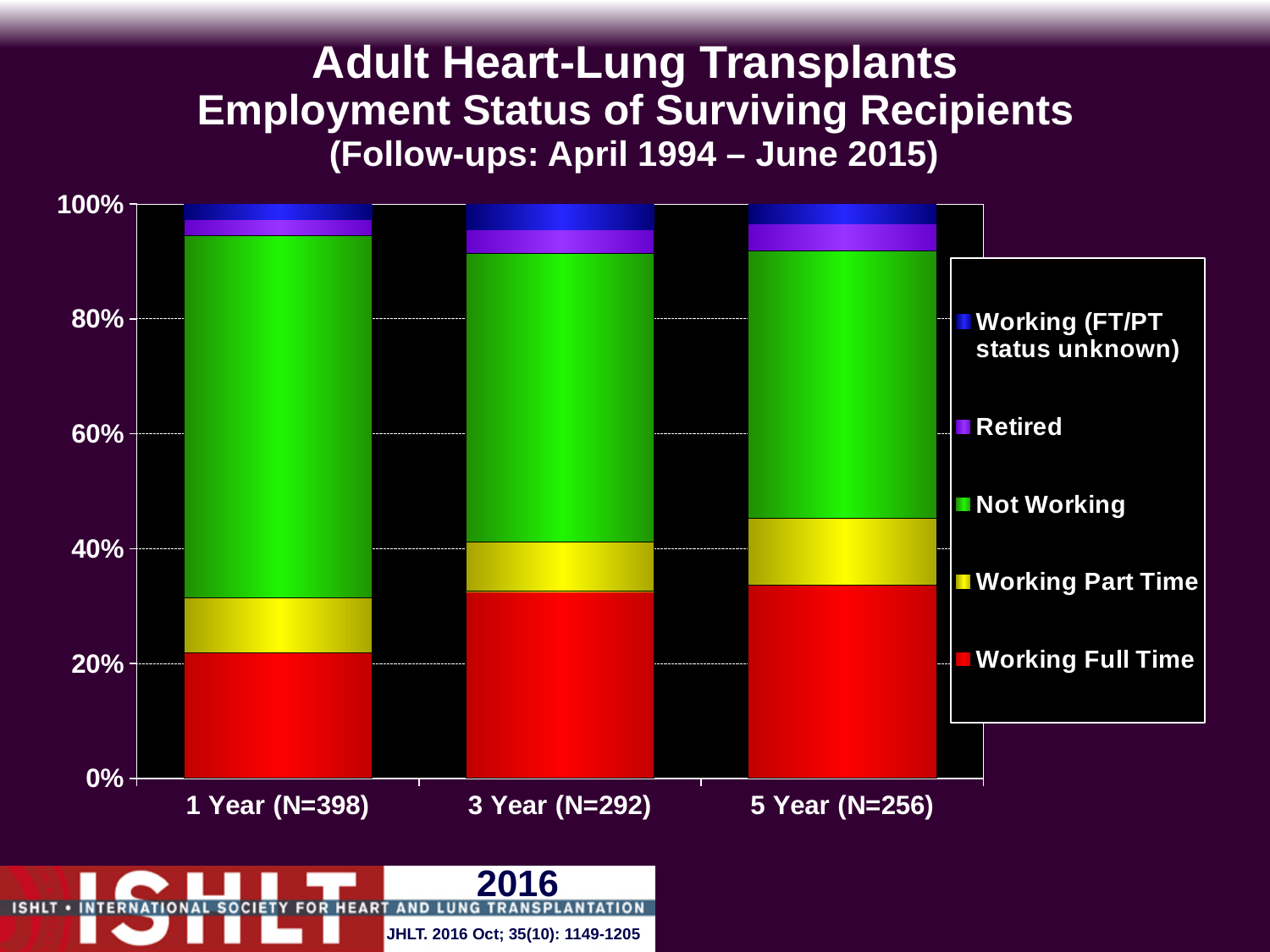
Is the Working Full Time share for 1 Year (N=398) greater or less than 40%? less Is the Not Working share for 1 Year (N=398) greater or less than 60%? greater How many series does the legend list? 5 Is the Working Full Time share for 3 Year (N=292) greater or less than 20%? greater What kind of chart is shown on the slide? stacked bar chart Which follow-up category has the smallest Working Full Time share? 1 Year (N=398) Which has the larger Working Full Time share, 1 Year (N=398) or 3 Year (N=292)? 3 Year (N=292) How many follow-up categories are shown on the x axis? 3 Does the Not Working share rise or fall from 1 Year to 5 Year? fall Which follow-up category has the largest Not Working share? 1 Year (N=398) Which has the larger Not Working share, 1 Year (N=398) or 5 Year (N=256)? 1 Year (N=398)